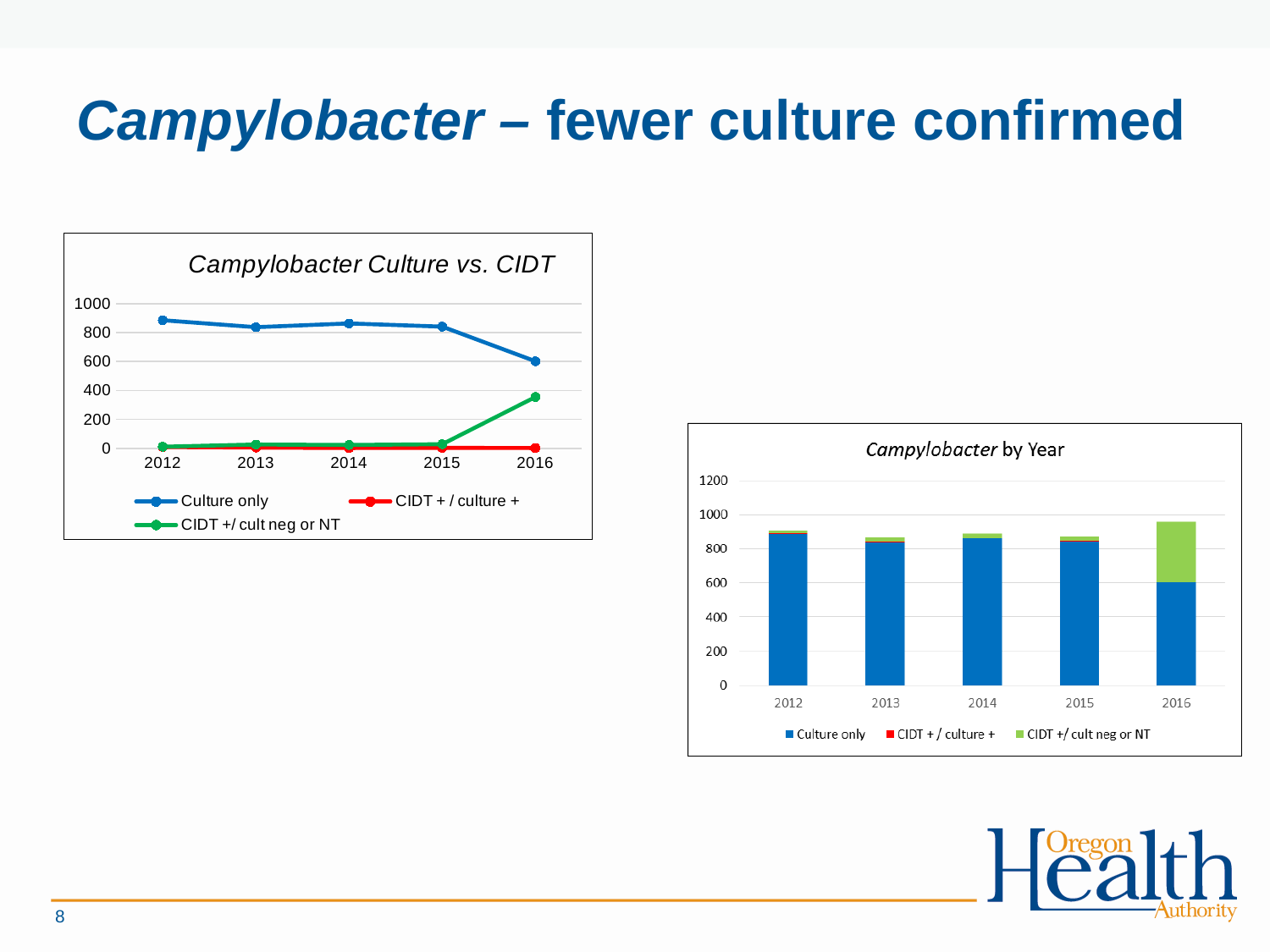
In the 'Campylobacter Culture vs. CIDT' chart, is the 'Culture only' value for 2016 greater or less than 800? less What is the title of the chart on the right side of the slide? Campylobacter by Year In the 'Campylobacter by Year' chart, is the total stacked bar for 2016 greater or less than 800? greater What kind of chart is the 'Campylobacter Culture vs. CIDT' chart on the left? line chart In the 'Campylobacter Culture vs. CIDT' chart, how many series does the legend list? 3 In the 'Campylobacter Culture vs. CIDT' chart, is the 'CIDT +/ cult neg or NT' value for 2016 greater or less than 200? greater In the 'Campylobacter by Year' chart, how many years are shown on the x axis? 5 In the 'Campylobacter Culture vs. CIDT' chart, which year has the highest 'CIDT +/ cult neg or NT' value? 2016 In the 'Campylobacter Culture vs. CIDT' chart, which series has the larger value in 2016: 'Culture only' or 'CIDT +/ cult neg or NT'? Culture only In the 'Campylobacter Culture vs. CIDT' chart, which year has the lowest 'Culture only' value? 2016 What kind of chart is the 'Campylobacter by Year' chart on the right? bar chart In the 'Campylobacter Culture vs. CIDT' chart, does the 'Culture only' line rise or fall from 2015 to 2016? fall